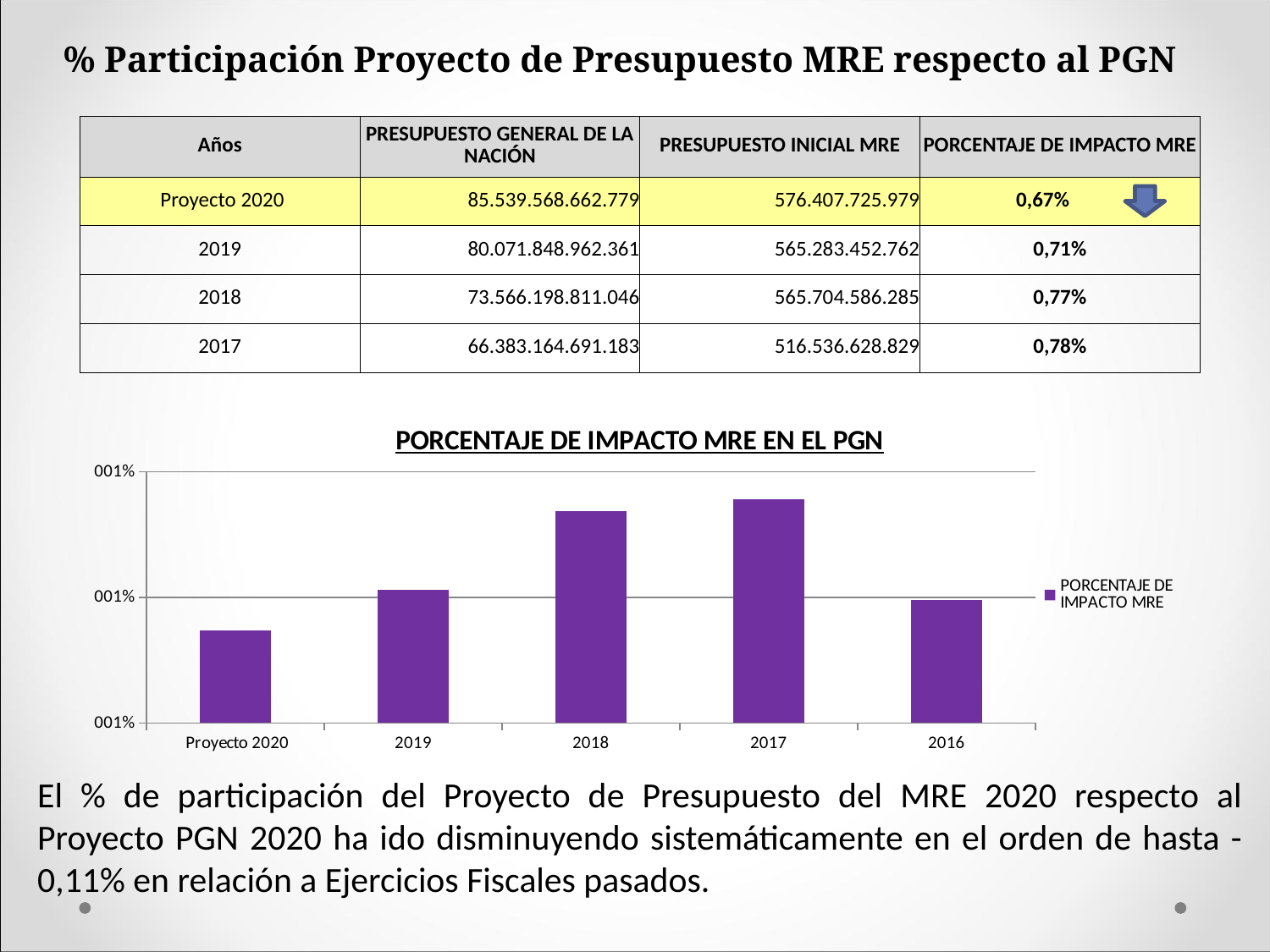
In the chart, which bar is taller: 2018 or 2019? 2018 Do the bars rise or fall moving along the x axis from Proyecto 2020 to 2017? Rise What is the title of the chart? PORCENTAJE DE IMPACTO MRE EN EL PGN How many series does the chart legend list? 1 What is the PORCENTAJE DE IMPACTO MRE value for Proyecto 2020? 0,67% In the chart, which bar is taller: Proyecto 2020 or 2016? 2016 What type of chart is shown on the slide? Bar chart Which category has the lowest bar in the chart? Proyecto 2020 Which category has the highest bar in the chart? 2017 What is the difference between the PORCENTAJE DE IMPACTO MRE for 2017 and for Proyecto 2020? 0,11% What is the name of the series in the chart legend? PORCENTAJE DE IMPACTO MRE How many categories are shown on the x axis of the chart? 5